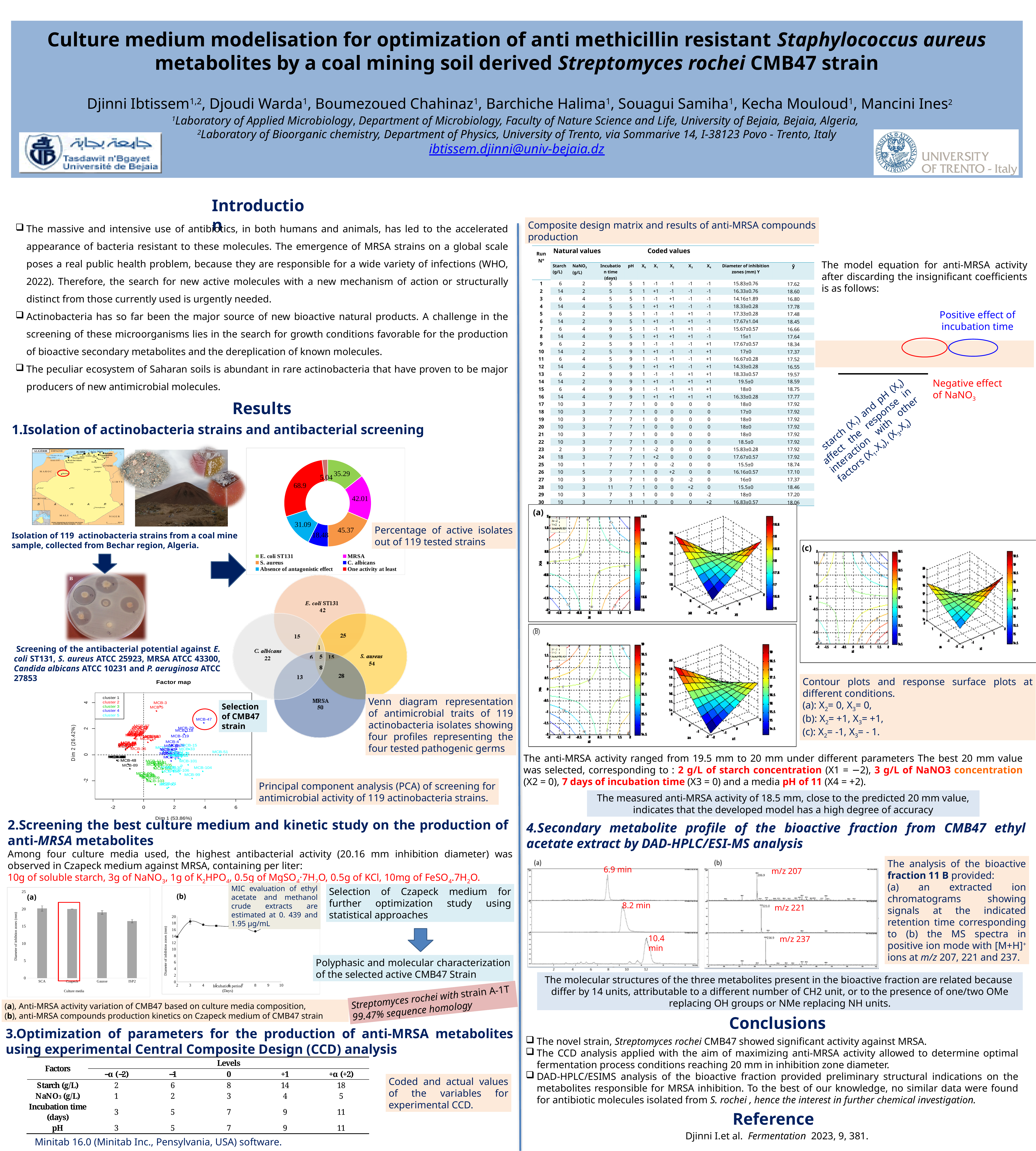
In the donut chart of the percentage of active isolates out of 119 tested strains, what value is shown for MRSA? 42.01 In chart (a) showing anti-MRSA activity variation of CMB47 based on culture media composition, which culture medium has the lowest inhibition zone diameter? ISP2 How many entries does the legend of the donut chart of the percentage of active isolates list? 6 In the donut chart of the percentage of active isolates, which is larger, the value for MRSA or the value for E. coli ST131? MRSA In chart (a) showing anti-MRSA activity variation of CMB47 based on culture media composition, how many culture media are plotted? 4 In the extracted ion chromatograms (a) of the bioactive fraction, what retention time is labelled on the first (top) peak? 6.9 min In the donut chart of the percentage of active isolates, which of the four tested pathogens (E. coli ST131, MRSA, S. aureus, C. albicans) has the lowest value? C. albicans In chart (a) showing anti-MRSA activity variation of CMB47 based on culture media composition, is the value for ISP2 greater or less than 20? less In the donut chart of the percentage of active isolates, what value is shown for C. albicans? 18.48 In the donut chart of the percentage of active isolates, what is the difference between the values for S. aureus and MRSA? 3.36 In the donut chart of the percentage of active isolates, what value is shown for S. aureus? 45.37 What kind of chart is chart (a) showing anti-MRSA activity variation of CMB47 based on culture media composition? bar chart